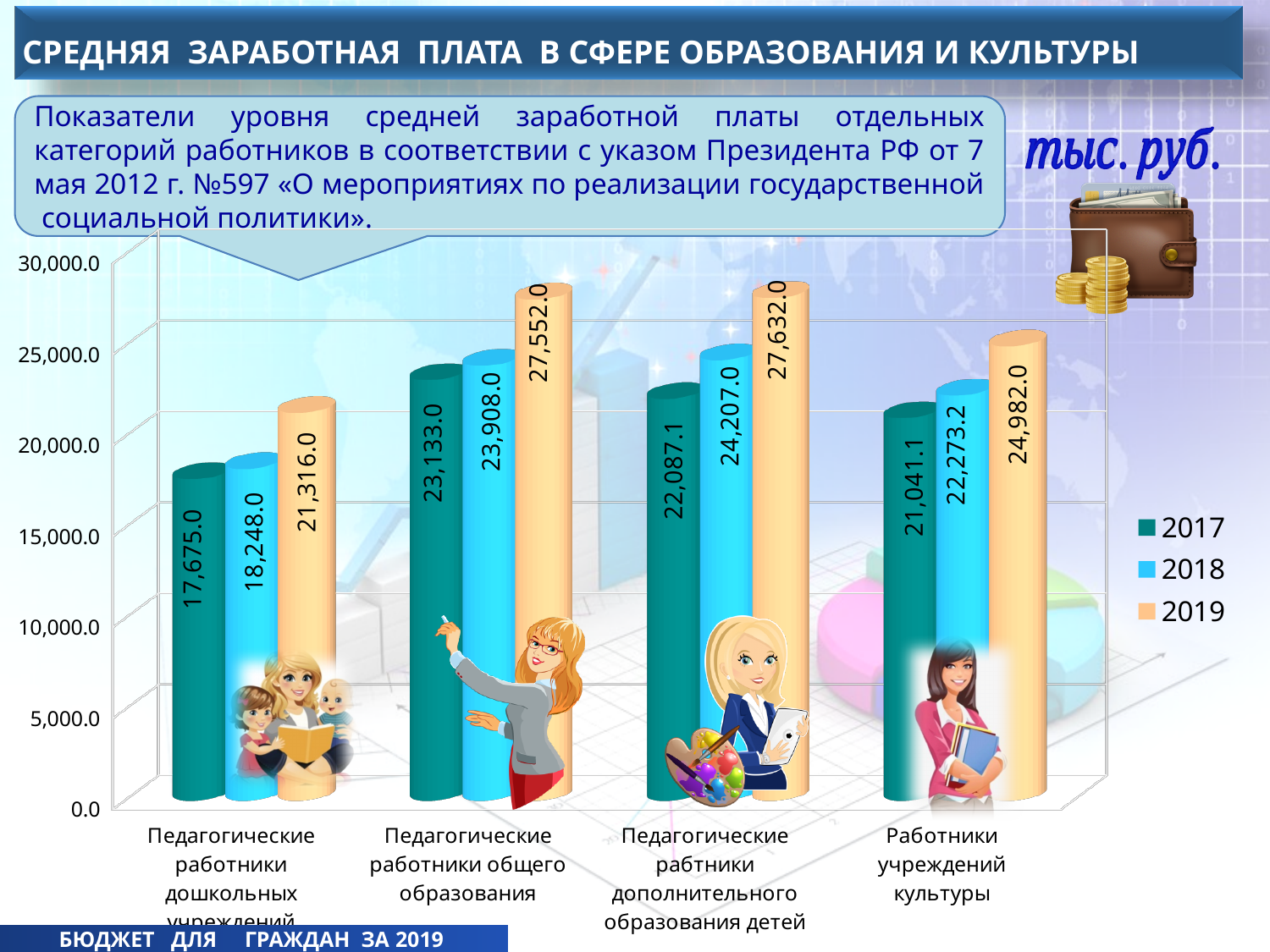
What was the average salary for Работники учреждений культуры in 2019? 24,982.0 Do the values for Педагогические работники общего образования rise or fall from 2017 to 2019? rise What was the average salary for Педагогические работники дополнительного образования детей in 2017? 22,087.1 By how much did the average salary for Педагогические работники дошкольных учреждений increase from 2017 to 2019? 3,641.0 What is the difference between the 2019 and 2018 values for Работники учреждений культуры? 2,708.8 Which is larger: the 2018 value for Педагогические работники общего образования or the 2018 value for Работники учреждений культуры? Педагогические работники общего образования How many categories of workers are shown on the chart? 4 How many series does the legend list? 3 What was the average salary for Педагогические работники общего образования in 2018? 23,908.0 What was the average salary for Педагогические работники дошкольных учреждений in 2017? 17,675.0 Which category had the highest average salary in 2019? Педагогические работники дополнительного образования детей Which category had the lowest average salary in 2017? Педагогические работники дошкольных учреждений